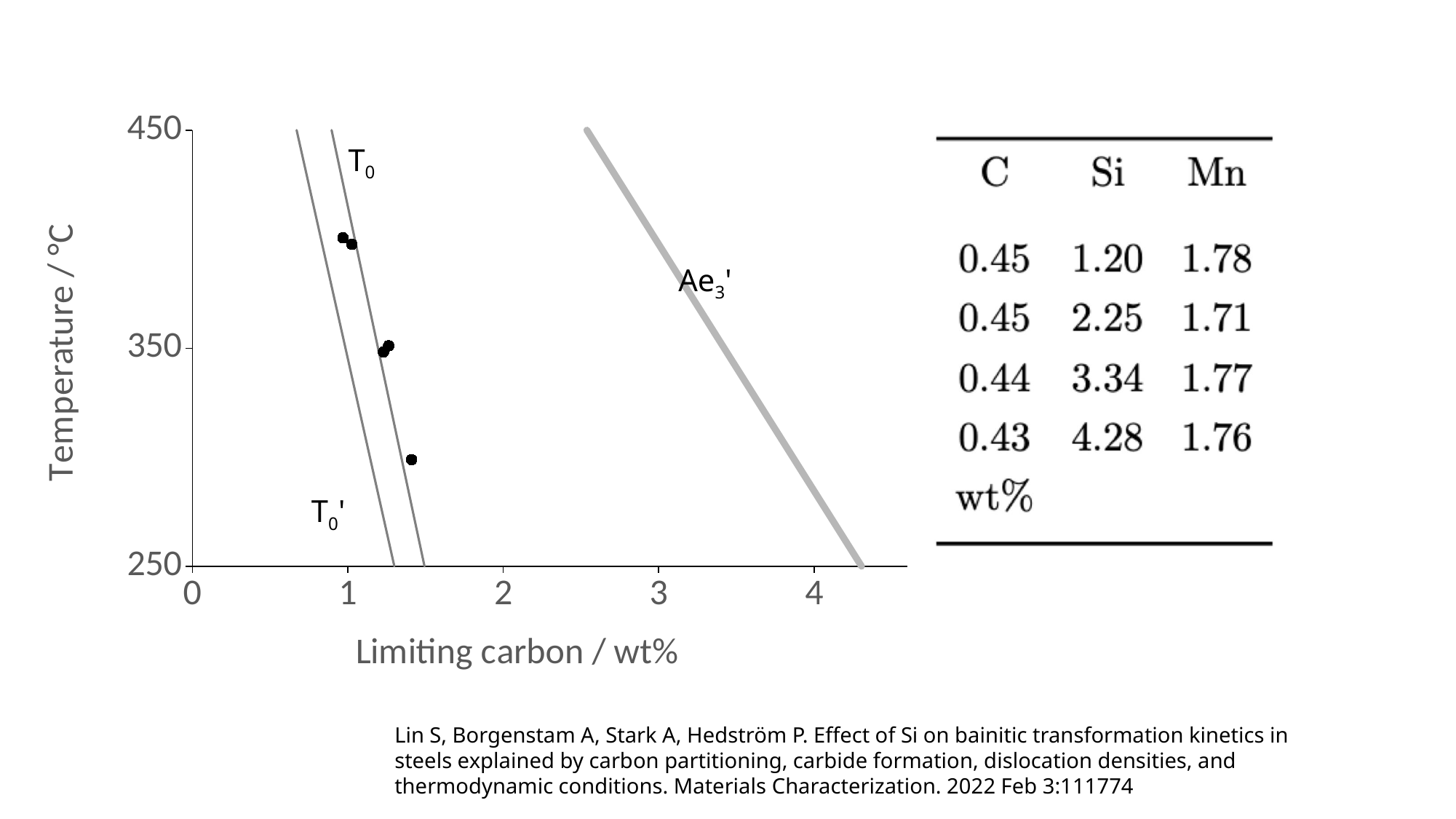
What is the label of the y axis of the chart? Temperature / °C Which labelled line lies furthest to the right on the chart? Ae3' Is the temperature of the lowest plotted data point greater or less than 350 °C? less Is the temperature of the highest plotted data point greater or less than 350 °C? greater Is the limiting carbon where the T0 line reaches 450 °C greater or less than 1 wt%? less What is the label of the x axis of the chart? Limiting carbon / wt% Along the Ae3' line, does temperature rise or fall as limiting carbon increases? Fall How many labelled lines are drawn on the chart? 3 What kind of chart is shown on the slide? Scatter chart with lines Which labelled line lies furthest to the left on the chart? T0'